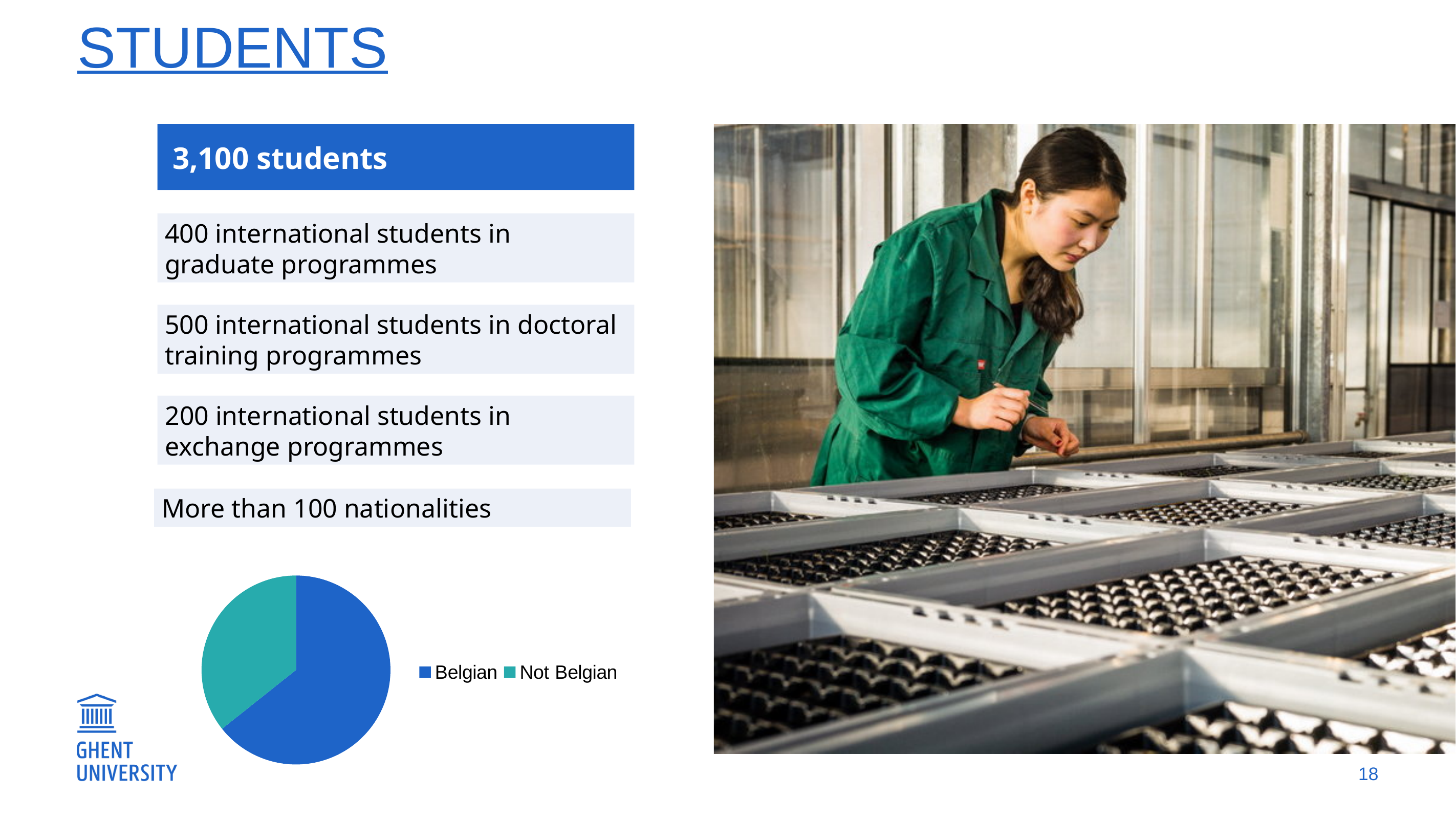
What kind of chart is shown at the bottom left of the slide? pie chart What colour is the Belgian slice in the pie chart? blue What are the two categories listed in the pie chart's legend? Belgian and Not Belgian Which slice of the pie chart is the smallest? Not Belgian Does the Belgian slice of the pie chart account for more or less than half of the pie? more How many entries does the pie chart's legend list? 2 How many slices does the pie chart have? 2 In the pie chart, which is larger: the Belgian slice or the Not Belgian slice? Belgian Which slice of the pie chart is the largest? Belgian